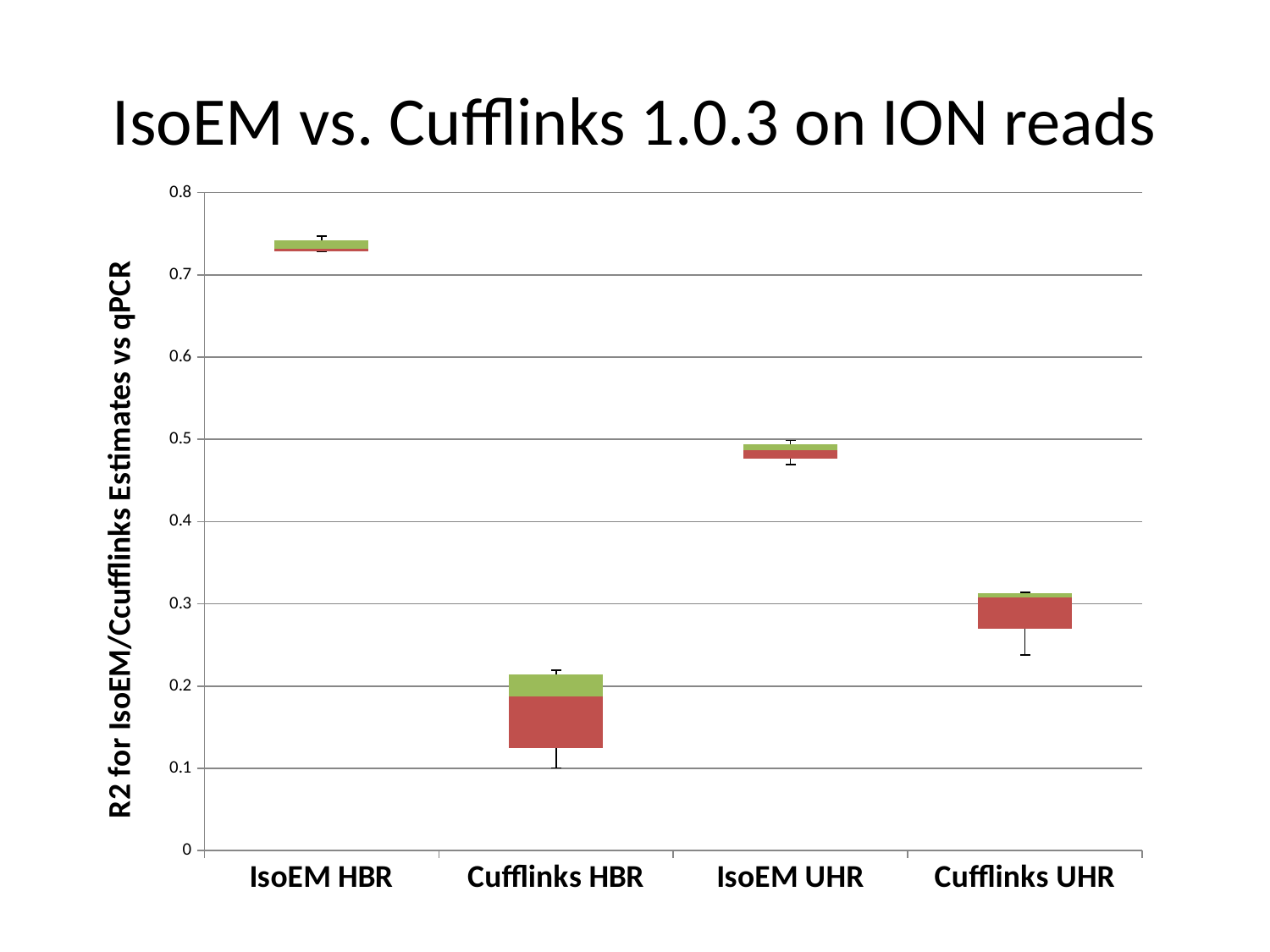
How many categories are shown on the x axis? 4 Which category has the lowest R2 values? Cufflinks HBR Is the value for Cufflinks HBR greater or less than 0.3? less Is the value for Cufflinks UHR greater or less than 0.4? less Is the value for IsoEM HBR greater or less than 0.7? greater What kind of chart is shown on the slide? Box plot (box-and-whisker chart) What is the title of the chart? IsoEM vs. Cufflinks 1.0.3 on ION reads Which has higher R2 values, IsoEM HBR or IsoEM UHR? IsoEM HBR What is the label of the y axis? R2 for IsoEM/Ccufflinks Estimates vs qPCR Which has higher R2 values, IsoEM UHR or Cufflinks UHR? IsoEM UHR Which has higher R2 values, IsoEM HBR or Cufflinks HBR? IsoEM HBR Which category has the highest R2 values? IsoEM HBR